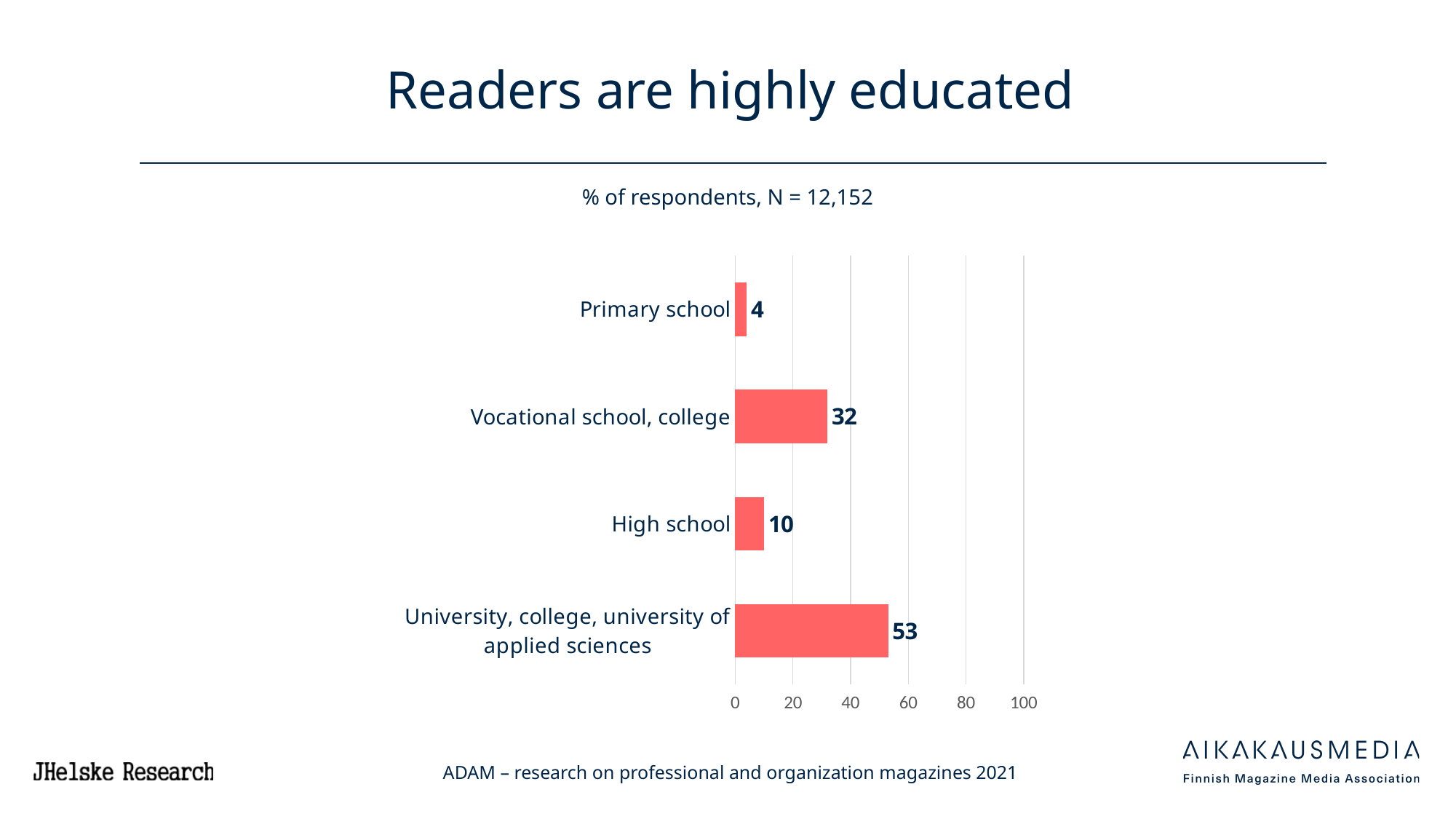
How many education categories are shown in the chart? 4 Which education category has the highest share of respondents? University, college, university of applied sciences Is the value for University, college, university of applied sciences greater or less than 40? greater What is the difference between the values for University, college, university of applied sciences and Vocational school, college? 21 What percentage of respondents have a primary school education? 4 Which is larger, the value for High school or the value for Vocational school, college? Vocational school, college What is the value for High school? 10 What is the value for Vocational school, college? 32 What is the value for University, college, university of applied sciences? 53 What kind of chart is shown on the slide? Bar chart Which education category has the lowest share of respondents? Primary school What is the number of respondents (N) stated in the chart subtitle? 12,152